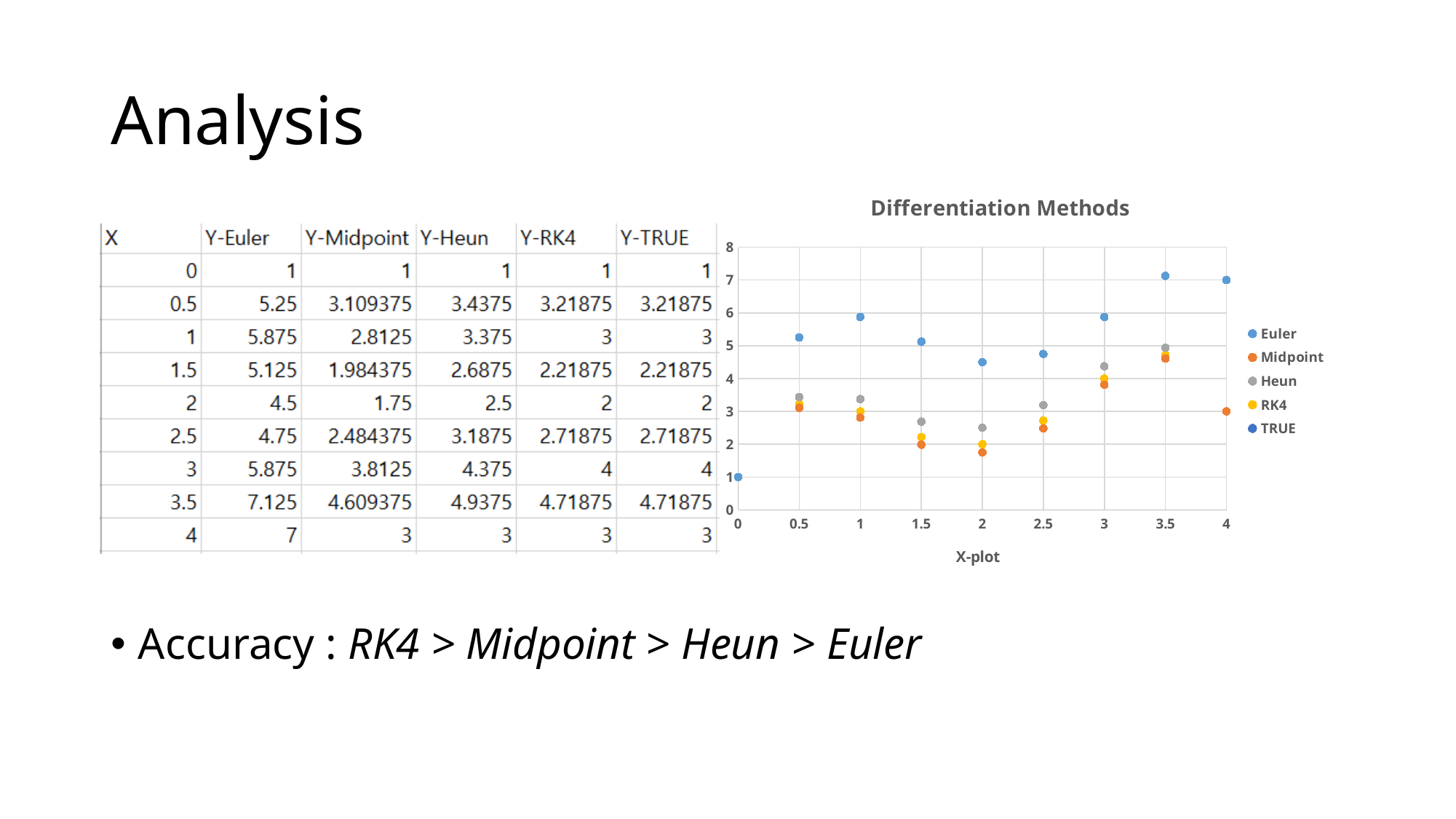
In the Differentiation Methods chart, at x = 2, which is larger: the Euler value or the Midpoint value? Euler In the Differentiation Methods chart, what is the Euler value at x = 3.5? 7.125 What is the x-axis title of the Differentiation Methods chart? X-plot What kind of chart is the Differentiation Methods chart? scatter chart How many x values are plotted for each series in the Differentiation Methods chart? 9 In the Differentiation Methods chart, is the Euler value at x = 0.5 greater or less than 4? greater In the Differentiation Methods chart, what is the Euler value at x = 4? 7 Does the Euler series in the Differentiation Methods chart rise or fall from x = 2 to x = 3.5? rise In the Differentiation Methods chart, what is the difference between the Euler value and the TRUE value at x = 4? 4 How many series does the legend of the Differentiation Methods chart list? 5 In the Differentiation Methods chart, at which x value does the Euler series reach its highest point? 3.5 In the Differentiation Methods chart, at which x value does the Midpoint series reach its lowest point? 2